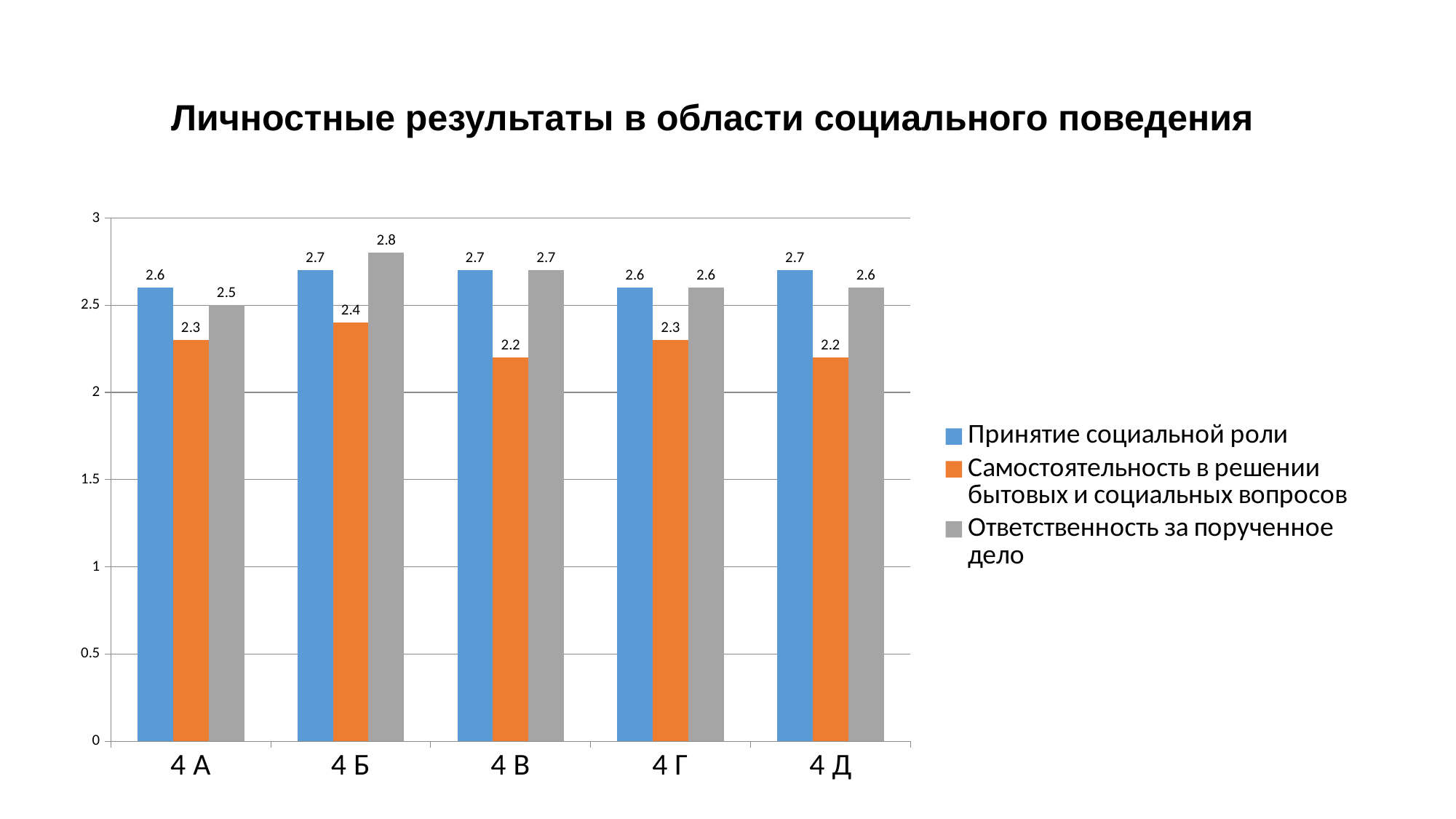
What is the value of Принятие социальной роли for class 4 А? 2.6 What is the value of Самостоятельность в решении бытовых и социальных вопросов for class 4 Б? 2.4 Which class has the highest value for Ответственность за порученное дело? 4 Б What is the difference between Принятие социальной роли and Самостоятельность в решении бытовых и социальных вопросов for class 4 В? 0.5 What is the title of the chart? Личностные результаты в области социального поведения What is the value of Ответственность за порученное дело for class 4 Д? 2.6 How many classes are shown on the x axis? 5 Is the value of Самостоятельность в решении бытовых и социальных вопросов for class 4 Д greater or less than 2.5? less How many series does the legend list? 3 Which class has the lowest value for Ответственность за порученное дело? 4 А Which is larger for class 4 Б: Принятие социальной роли or Ответственность за порученное дело? Ответственность за порученное дело What kind of chart is shown on the slide? bar chart